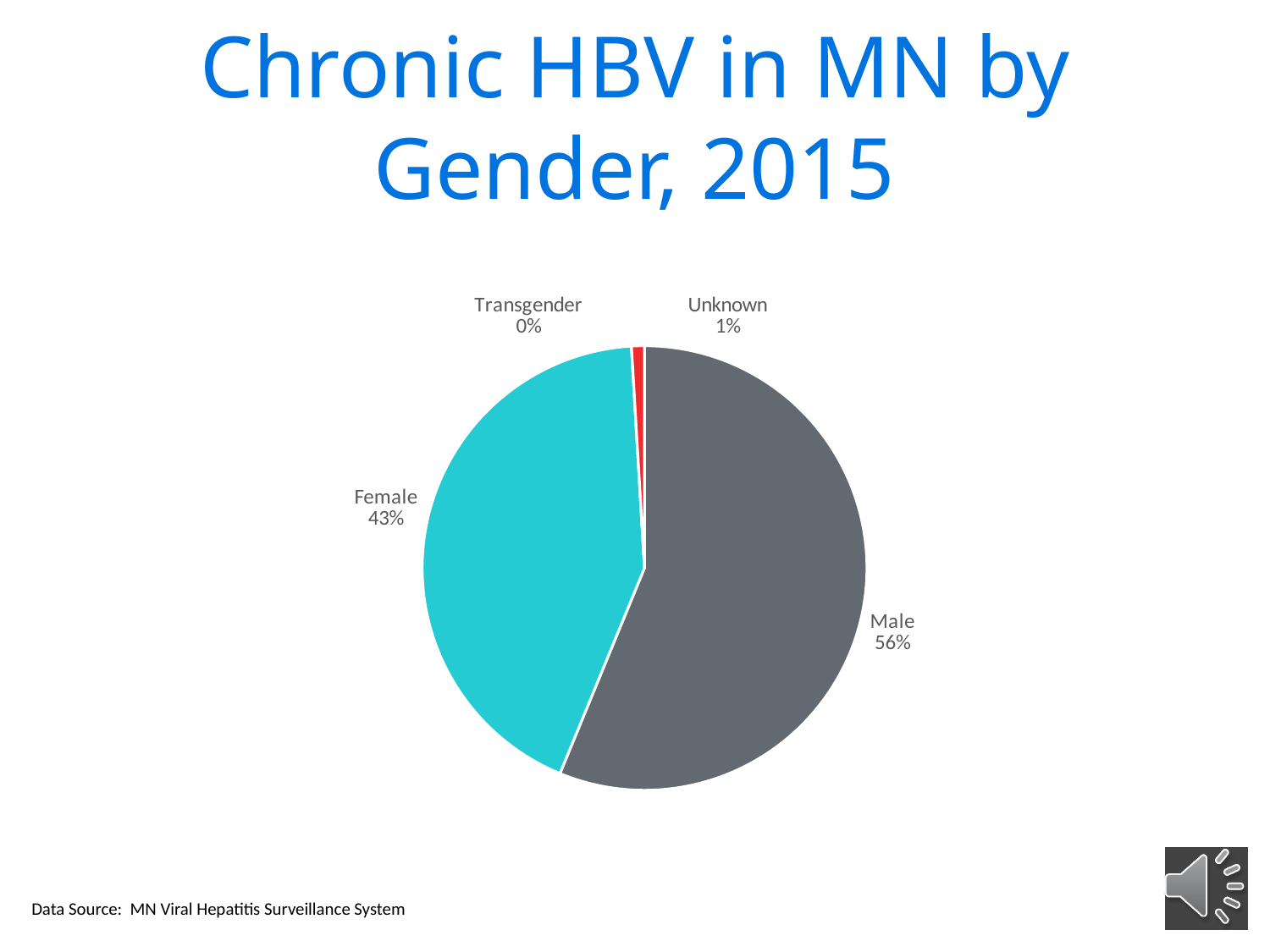
What share of chronic HBV cases in MN in 2015 is Female? 43% Which gender category has the largest share of the pie? Male What kind of chart is shown on the slide? Pie chart What share of chronic HBV cases in MN in 2015 is Male? 56% What is the difference in percentage points between the Male and Female shares? 13 Which labelled category has the smallest share of the pie? Transgender What percentage is shown for the Unknown slice? 1% What percentage is shown for the Transgender slice? 0% Which is larger, the Male share or the Female share? Male What data source is cited on the slide? MN Viral Hepatitis Surveillance System How many categories are shown in the pie chart? 4 What is the title of the chart? Chronic HBV in MN by Gender, 2015